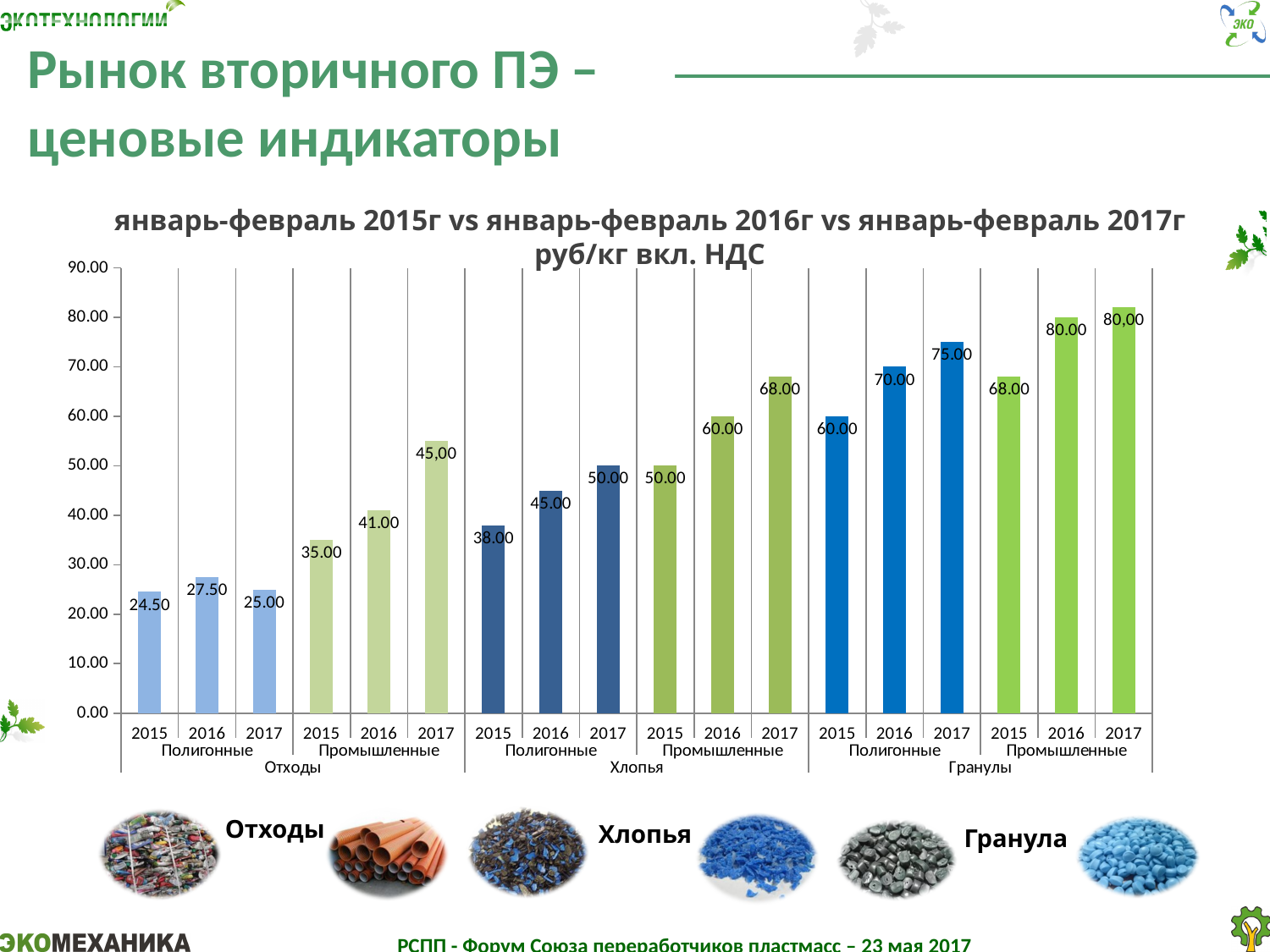
What is the value for Отходы, Промышленные in 2017? 45,00 Do the values for Гранулы, Полигонные rise or fall from 2015 to 2017? rise What is the value for Гранулы, Полигонные in 2016? 70.00 What is the value for Хлопья, Промышленные in 2017? 68.00 What type of chart is shown on the slide? bar chart What unit is stated in the chart title? руб/кг вкл. НДС Which bar has the lowest value on the chart? Отходы, Полигонные, 2015 Is the value for Хлопья, Промышленные in 2016 greater or less than 50.00? greater What is the value for Отходы, Полигонные in 2015? 24.50 Which is larger: Гранулы, Полигонные in 2017 or Гранулы, Промышленные in 2015? Гранулы, Полигонные in 2017 How many bars are plotted on the chart? 18 What is the difference between the 2017 and 2015 values for Хлопья, Полигонные? 12.00